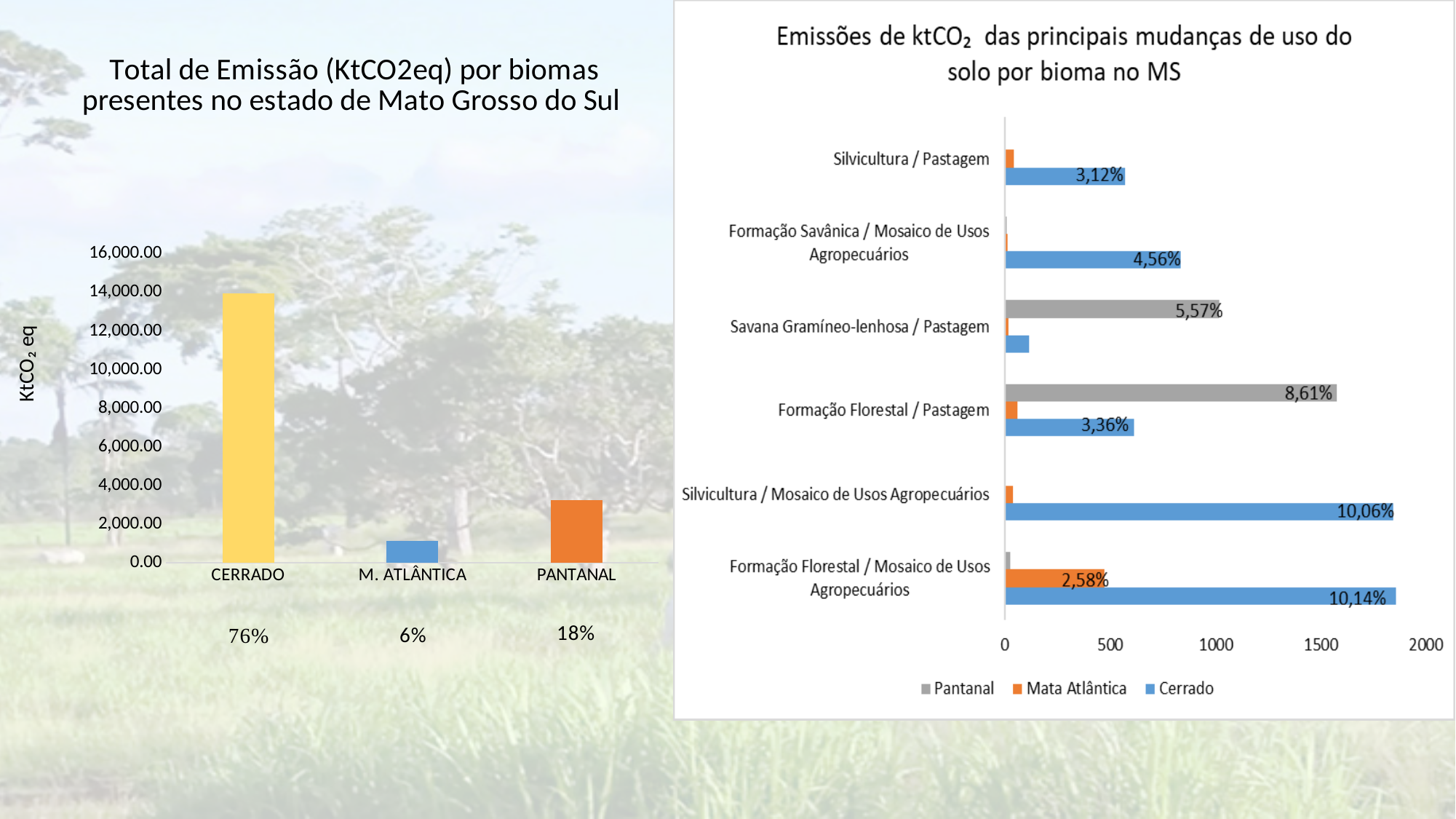
What kind of chart is the left chart titled 'Total de Emissão (KtCO2eq) por biomas presentes no estado de Mato Grosso do Sul'? bar chart In the right chart (Emissões de ktCO₂ por bioma no MS), is the Cerrado bar for Formação Florestal / Mosaico de Usos Agropecuários greater or less than 1500? greater How many series does the legend list in the right chart (Emissões de ktCO₂ das principais mudanças de uso do solo por bioma no MS)? 3 In the left chart (Total de Emissão por biomas), what percentage is shown below CERRADO? 76% In the left chart (Total de Emissão por biomas), is the value for CERRADO greater or less than 12,000.00? greater In the right chart (Emissões de ktCO₂ por bioma no MS), what label is shown on the Pantanal bar for Formação Florestal / Pastagem? 8,61% In the right chart (Emissões de ktCO₂ por bioma no MS), what label is shown on the Cerrado bar for Silvicultura / Mosaico de Usos Agropecuários? 10,06% In the left chart (Total de Emissão por biomas), which biome has the lowest emission? M. ATLÂNTICA How many land-use change categories are shown in the right chart (Emissões de ktCO₂ por bioma no MS)? 6 In the left chart (Total de Emissão por biomas), what percentage is shown below PANTANAL? 18% In the left chart (Total de Emissão por biomas), which biome has the highest emission? CERRADO How many biomes are shown in the left chart (Total de Emissão por biomas)? 3